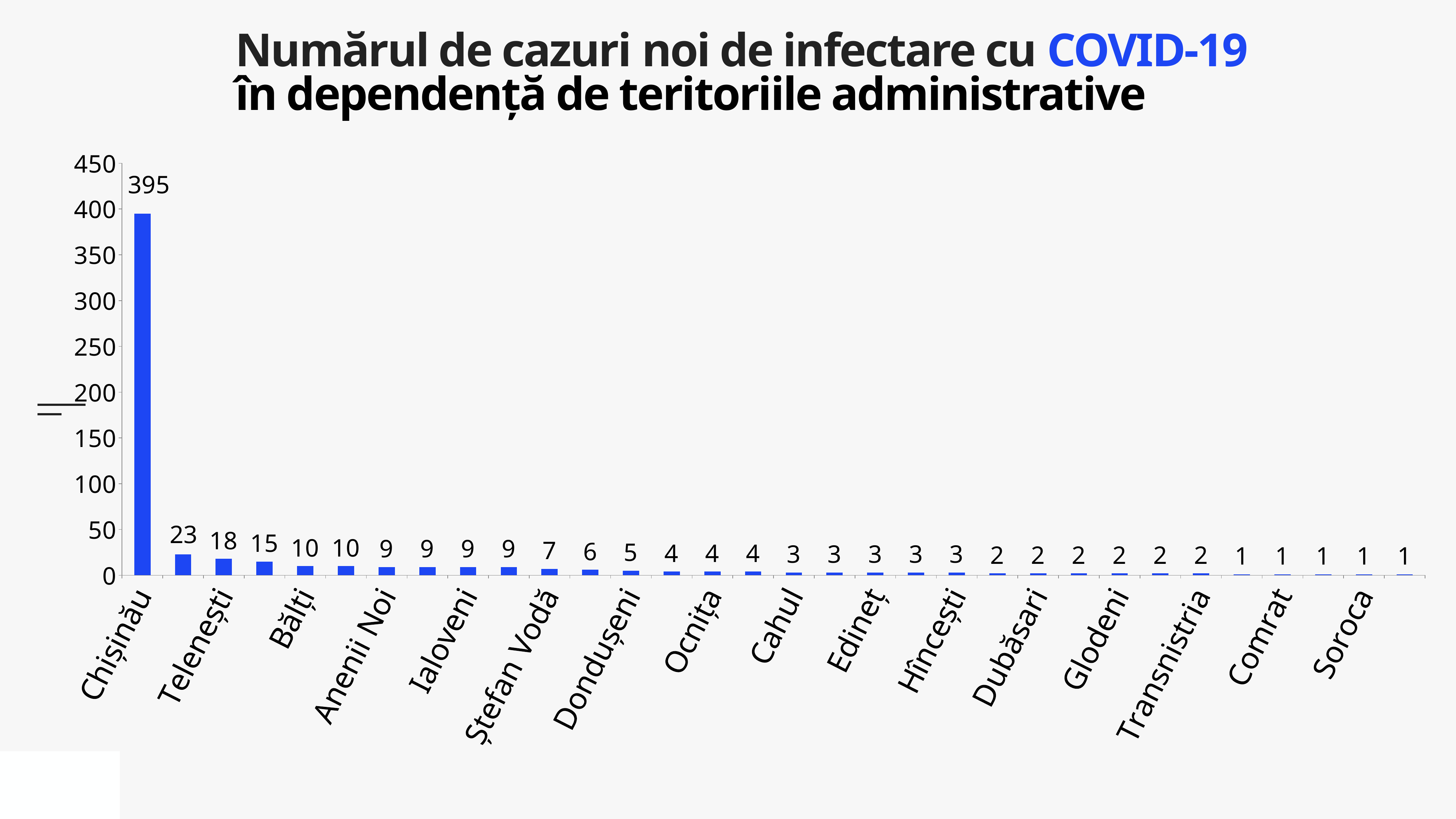
What is the value for Soroca? 1 Is the value for Chișinău greater or less than 350? greater Which is larger, the value for Chișinău or the value for Comrat? Chișinău Which is larger, the value for Chișinău or the value for Bălți? Chișinău Do the values rise or fall from left to right along the x axis? fall What is the value for Chișinău? 395 What is the value for Ialoveni? 9 Is the value for Telenești greater or less than 50? less What colour are the bars? blue What is the highest value shown on the vertical axis? 450 What kind of chart is shown on the slide? bar chart Which category has the highest value? Chișinău